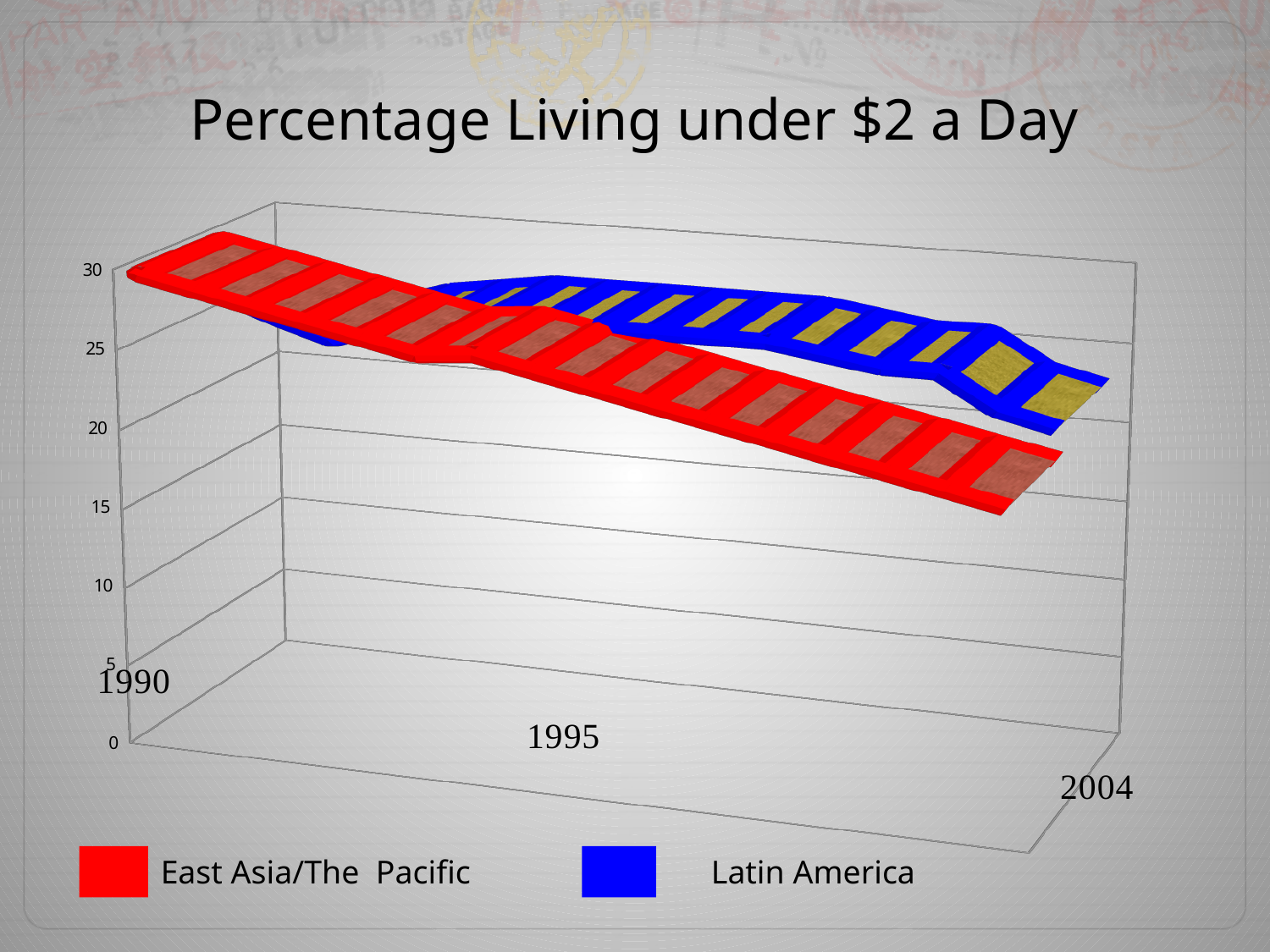
Is the value for Latin America in 1990 greater or less than 20? greater Is the value for East Asia/The Pacific in 1990 greater or less than 20? greater Does the value for East Asia/The Pacific rise or fall from 1990 to 2004? fall Is the value for East Asia/The Pacific in 2004 greater or less than 25? less Which series is shown in red? East Asia/The Pacific Which series has the higher value in 2004, East Asia/The Pacific or Latin America? Latin America How many years are labelled on the x axis? 3 What is the title of the chart? Percentage Living under $2 a Day How many series does the legend list? 2 Which series has the higher value in 1990, East Asia/The Pacific or Latin America? East Asia/The Pacific What kind of chart is shown on the slide? line chart